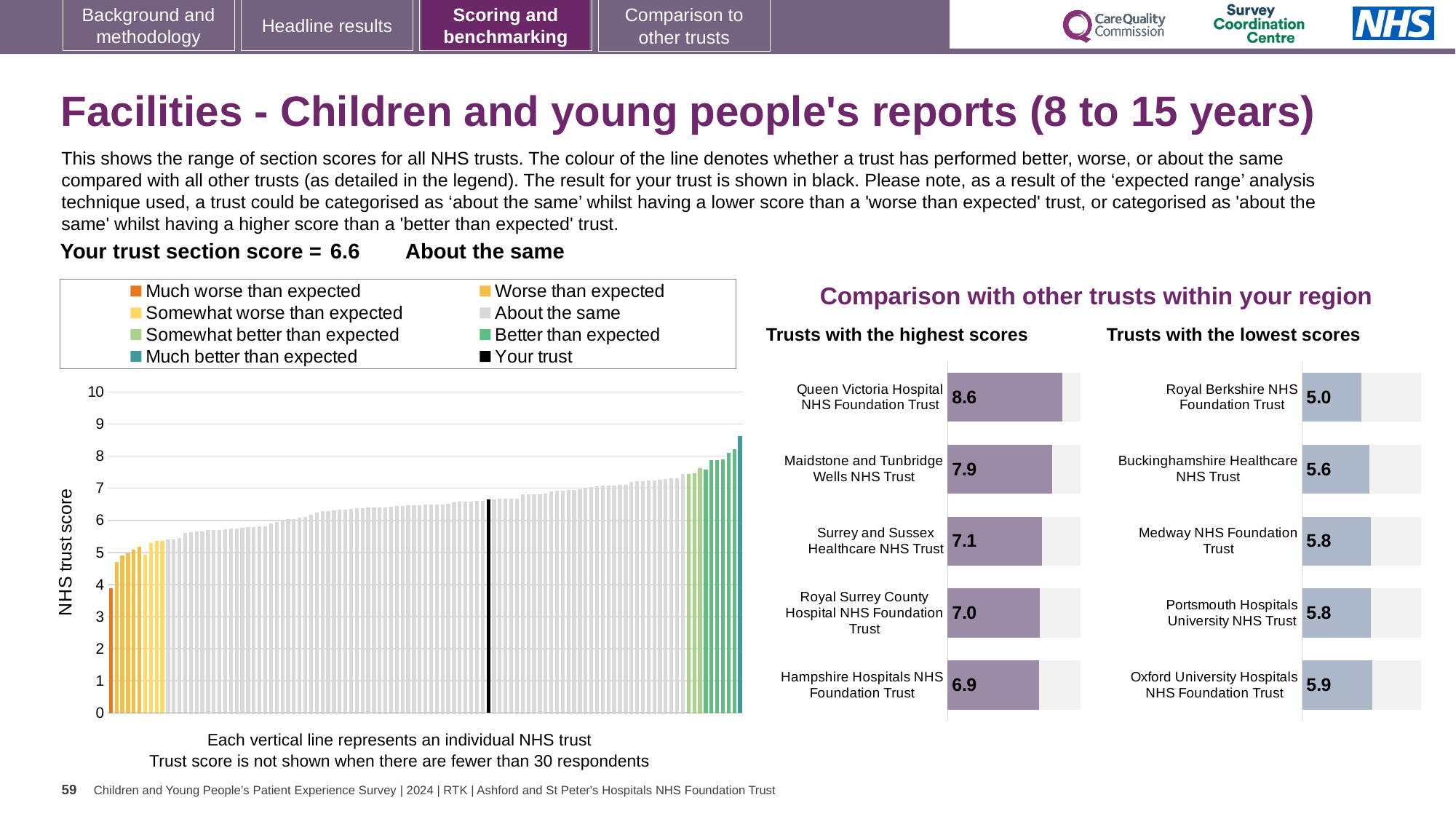
In the 'Trusts with the highest scores' chart, what is the score for Queen Victoria Hospital NHS Foundation Trust? 8.6 How many entries does the legend of the NHS trust score chart on the left list? 8 In the 'Trusts with the lowest scores' chart, what is the score for Royal Berkshire NHS Foundation Trust? 5.0 In the 'Trusts with the highest scores' chart, what is the difference between the scores of Queen Victoria Hospital NHS Foundation Trust and Hampshire Hospitals NHS Foundation Trust? 1.7 In the 'Trusts with the lowest scores' chart, how much higher is Oxford University Hospitals NHS Foundation Trust's score than Royal Berkshire NHS Foundation Trust's? 0.9 What kind of chart is the NHS trust score chart on the left of the slide? bar chart How many trusts are shown in the 'Trusts with the lowest scores' chart? 5 In the 'Trusts with the highest scores' chart, which trust has the highest score? Queen Victoria Hospital NHS Foundation Trust In the NHS trust score chart on the left, do the values rise or fall from left to right? rise In the 'Trusts with the highest scores' chart, which has the larger score: Maidstone and Tunbridge Wells NHS Trust or Surrey and Sussex Healthcare NHS Trust? Maidstone and Tunbridge Wells NHS Trust In the 'Trusts with the lowest scores' chart, which trust has the lowest score? Royal Berkshire NHS Foundation Trust In the NHS trust score chart on the left, is the value of the leftmost (orange) bar greater or less than 5? less